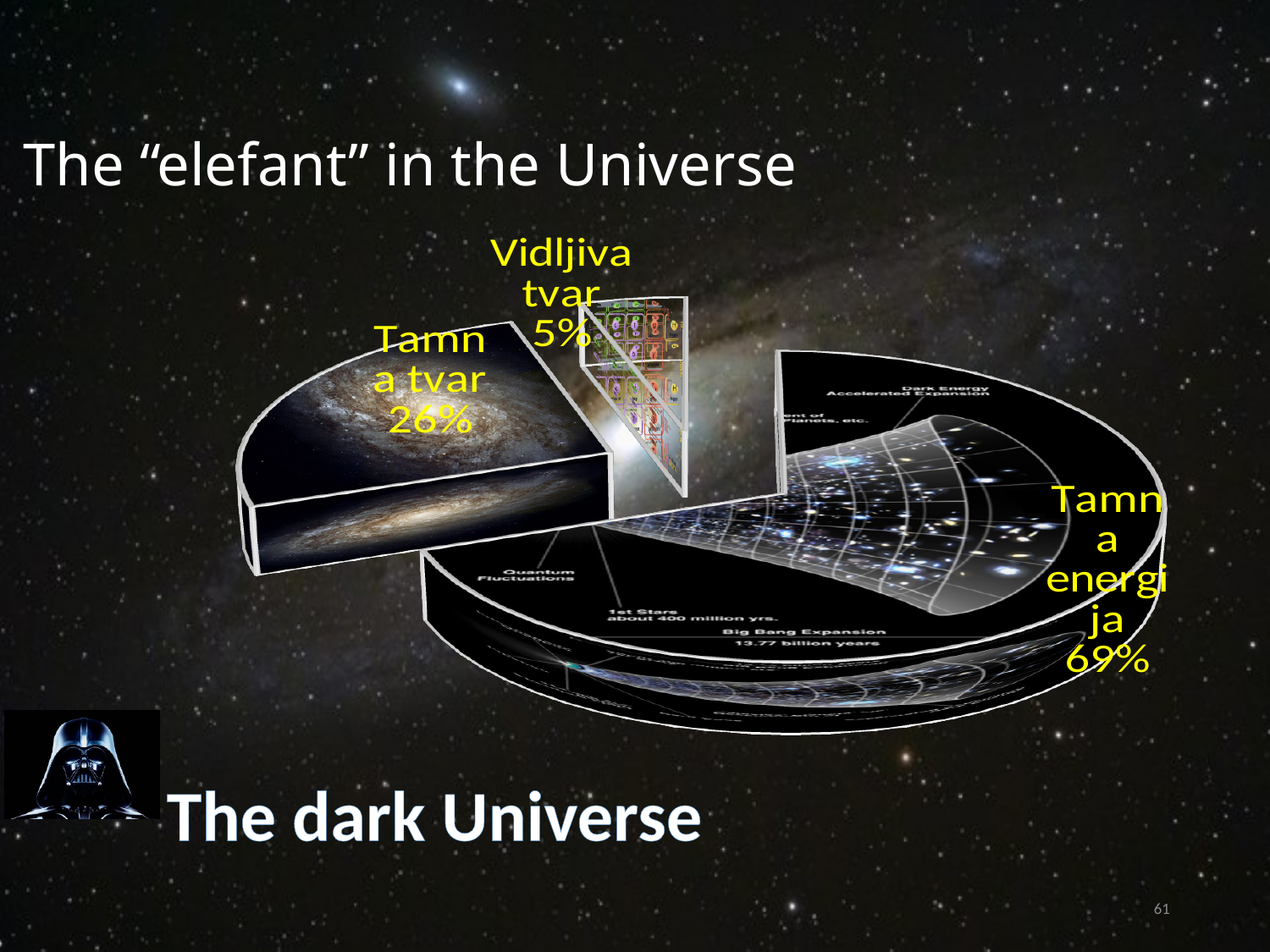
What is the combined share of Tamna tvar and Tamna energija in the pie chart? 95% What percentage does the pie chart show for Vidljiva tvar? 5% What percentage does the pie chart show for Tamna energija? 69% What is the difference in percentage points between Tamna tvar and Vidljiva tvar? 21 What percentage does the pie chart show for Tamna tvar? 26% What kind of chart is shown on the slide? Pie chart Which slice of the pie chart is the smallest? Vidljiva tvar Which slice of the pie chart is the largest? Tamna energija What is the difference in percentage points between Tamna energija and Tamna tvar? 43 How many slices does the pie chart have? 3 What is the title of the slide containing the pie chart? The "elefant" in the Universe Which is larger in the pie chart, Tamna tvar or Vidljiva tvar? Tamna tvar